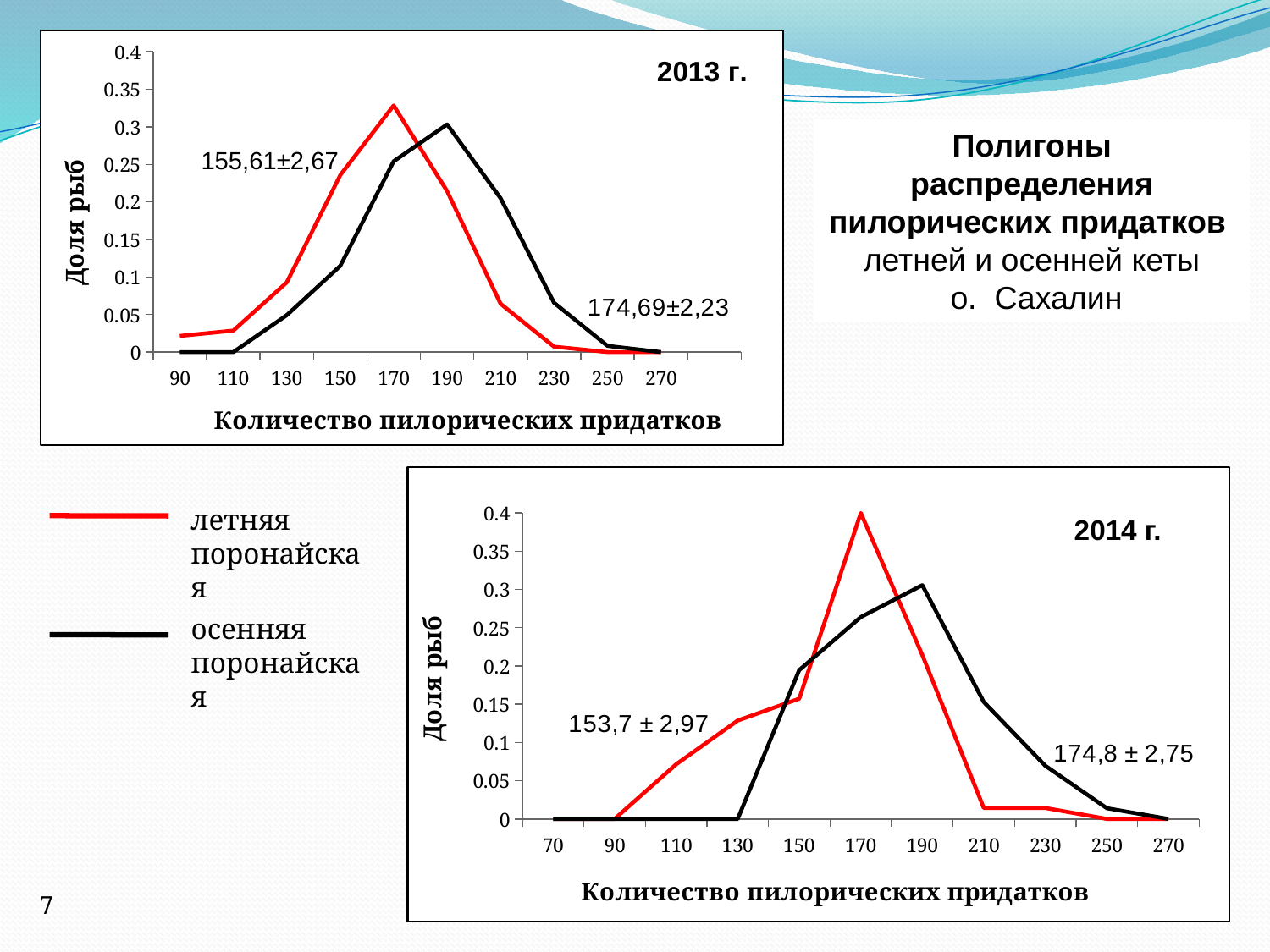
In the 2014 г. chart, what is the peak value of the red (летняя поронайская) line at 170 pyloric caeca? 0.4 In the 2013 г. chart, at 150 pyloric caeca, which line has the larger share of fish, red (летняя) or black (осенняя)? red (летняя поронайская) How many x-axis tick labels does the 2014 г. chart show? 11 In the 2013 г. chart, does the red (летняя поронайская) line rise or fall from 170 to 270 pyloric caeca? fall In the 2014 г. chart, what mean ± error value is printed next to the black (осенняя поронайская) line? 174,8 ± 2,75 In the 2013 г. chart, at which number of pyloric caeca does the red (летняя поронайская) line reach its peak? 170 How many series does the legend list for the charts? 2 What kind of chart is the 2013 г. chart? line chart In the 2013 г. chart, at which number of pyloric caeca does the black (осенняя поронайская) line reach its peak? 190 In the 2013 г. chart, is the peak value of the red (летняя поронайская) line greater or less than 0.3? greater In the 2014 г. chart, is the value of the black (осенняя поронайская) line at 210 pyloric caeca greater or less than 0.1? greater In the 2013 г. chart, at 210 pyloric caeca, which line has the larger share of fish, red (летняя) or black (осенняя)? black (осенняя поронайская)